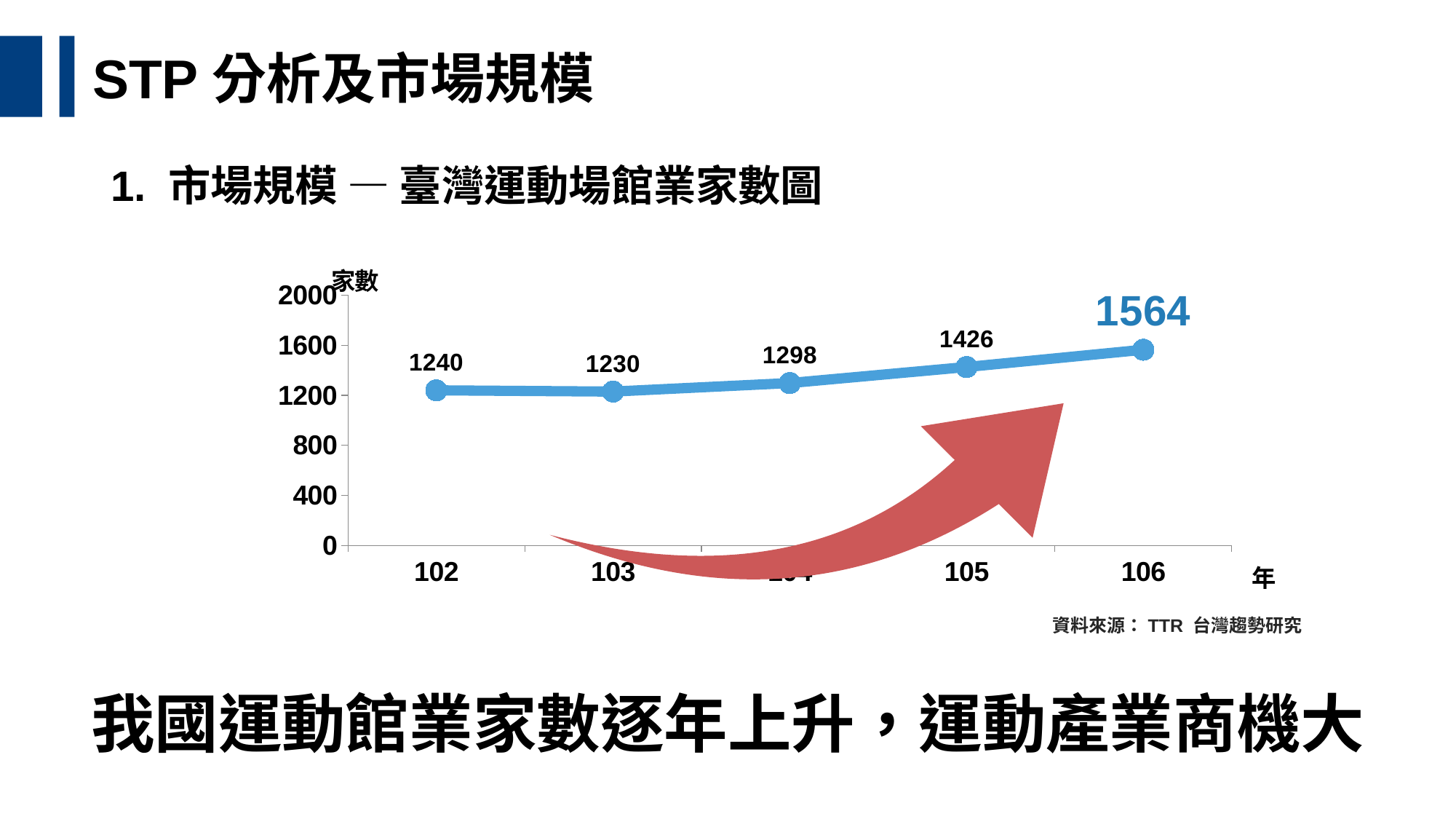
Which year has the lowest value on the chart? 103 What is the number of sports venue businesses (家數) in year 102? 1240 What is the label on the vertical axis of the chart? 家數 What is the value plotted for year 105? 1426 How many data points are plotted on the line? 5 What is the value plotted for year 106? 1564 Which is larger, the value for year 105 or the value for year 103? 105 What is the value plotted for year 103? 1230 What is the difference between the values for year 102 and year 103? 10 By how much did the value increase from year 105 to year 106? 138 What kind of chart is shown on the slide? Line chart Which year has the highest value on the chart? 106